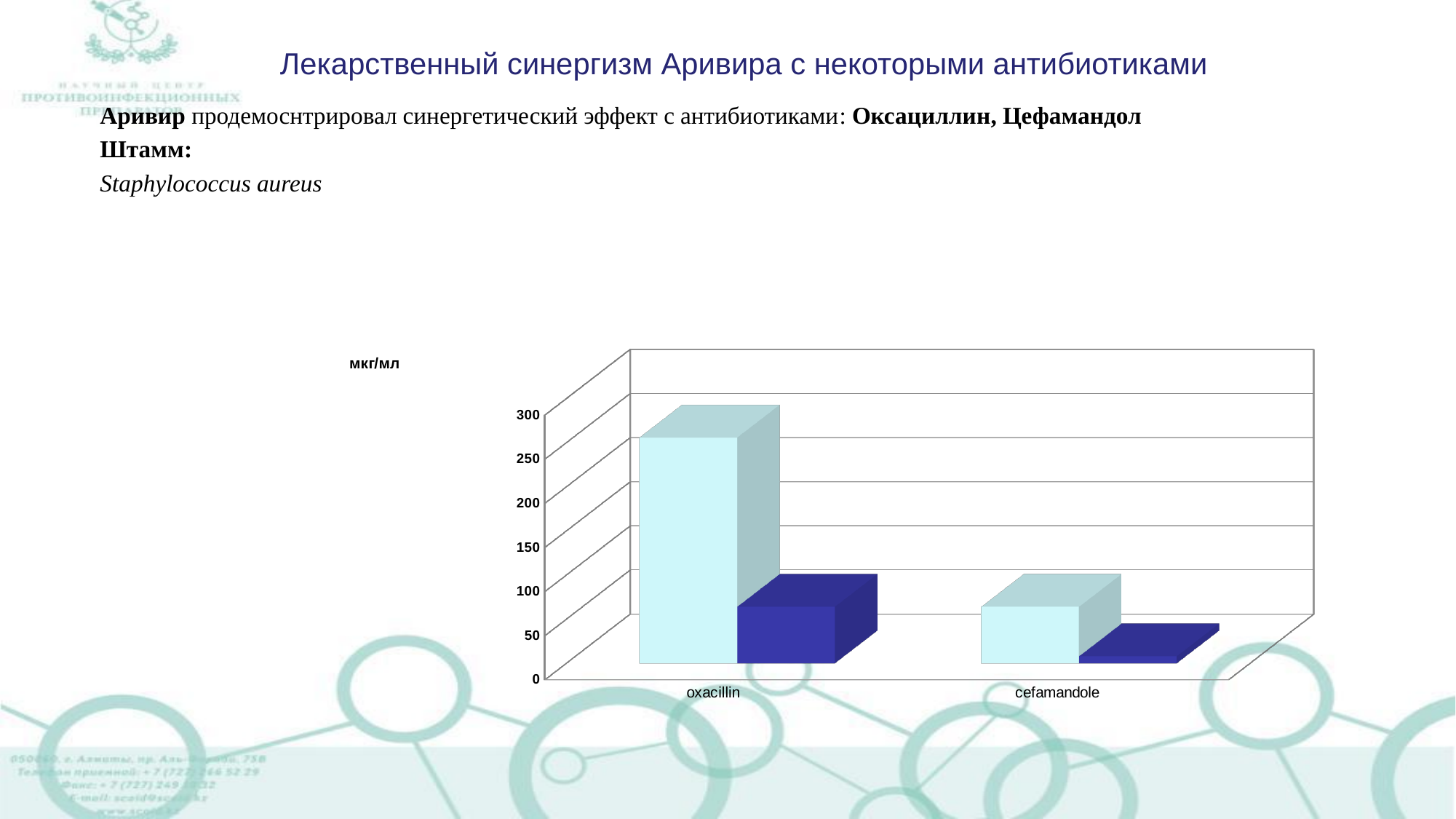
What unit label is shown on the vertical axis of the chart? мкг/мл Which is larger: the light blue bar for oxacillin or the light blue bar for cefamandole? oxacillin Do the light blue bars rise or fall from oxacillin to cefamandole? fall Is the value of the dark blue bar for cefamandole greater or less than 50? less What are the two categories on the x axis of the chart? oxacillin and cefamandole Is the value of the light blue bar for cefamandole greater or less than 150? less What kind of chart is shown on the slide? bar chart Is the value of the dark blue bar for oxacillin greater or less than 50? greater Which category has the tallest bar in the chart? oxacillin Which category has the shortest bar in the chart? cefamandole How many categories are shown on the x axis of the chart? 2